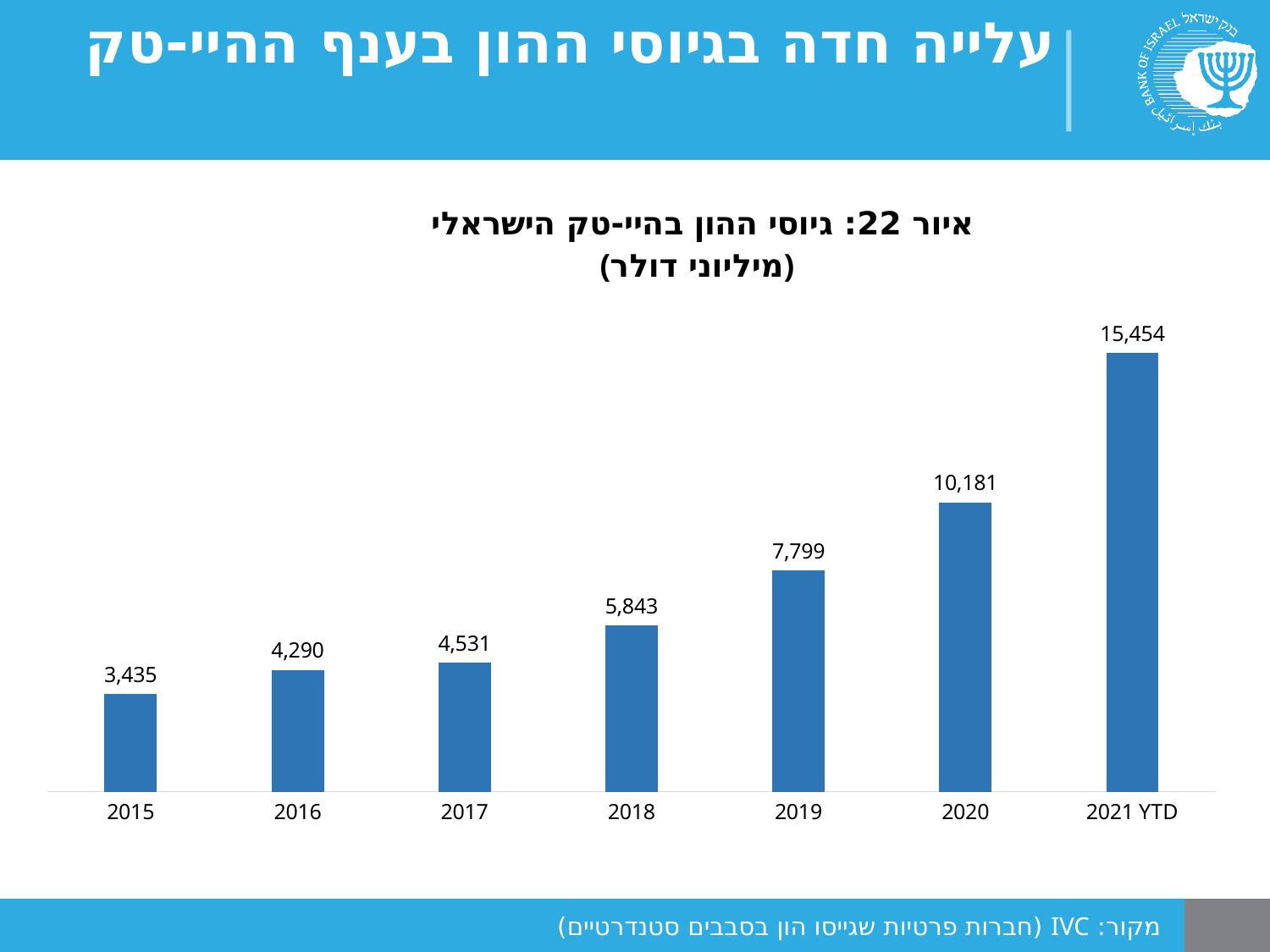
How many categories are shown on the x axis? 7 Which category has the highest value? 2021 YTD Which is larger, the value for 2017 or the value for 2018? 2018 What is the value for 2015? 3,435 Which category has the lowest value? 2015 What is the value for 2021 YTD? 15,454 What is the value for 2019? 7,799 What unit is given in parentheses in the chart title? מיליוני דולר What is the difference between the values for 2021 YTD and 2020? 5,273 Do the values rise or fall from 2015 to 2021 YTD? rise What is the difference between the values for 2020 and 2019? 2,382 What kind of chart is shown on the slide? bar chart